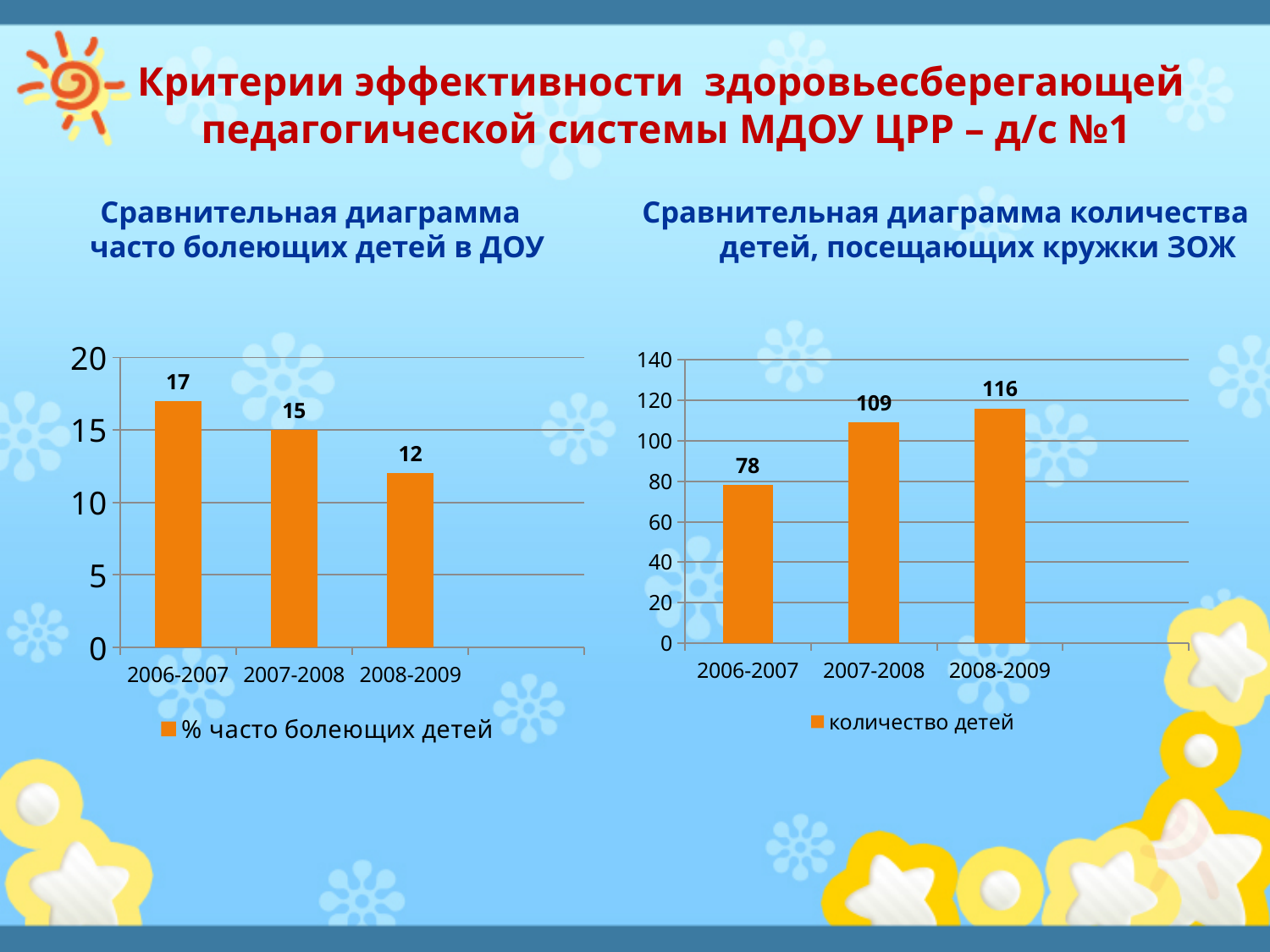
In the left chart (Сравнительная диаграмма часто болеющих детей в ДОУ), which year has the lowest value? 2008-2009 In the left chart (Сравнительная диаграмма часто болеющих детей в ДОУ), what is the value for 2006-2007? 17 In the right chart (Сравнительная диаграмма количества детей, посещающих кружки ЗОЖ), what is the value for 2007-2008? 109 In the left chart (Сравнительная диаграмма часто болеющих детей в ДОУ), do the values rise or fall from 2006-2007 to 2008-2009? fall In the right chart (Сравнительная диаграмма количества детей, посещающих кружки ЗОЖ), what is the difference between the values for 2008-2009 and 2006-2007? 38 What is the legend entry of the right chart (Сравнительная диаграмма количества детей, посещающих кружки ЗОЖ)? количество детей What kind of chart is the left chart (Сравнительная диаграмма часто болеющих детей в ДОУ)? bar chart In the right chart (Сравнительная диаграмма количества детей, посещающих кружки ЗОЖ), which year has the highest value? 2008-2009 In the left chart (Сравнительная диаграмма часто болеющих детей в ДОУ), what is the difference between the values for 2006-2007 and 2008-2009? 5 In the left chart (Сравнительная диаграмма часто болеющих детей в ДОУ), what is the value for 2008-2009? 12 In the right chart (Сравнительная диаграмма количества детей, посещающих кружки ЗОЖ), is the value for 2006-2007 greater or less than 100? less In the right chart (Сравнительная диаграмма количества детей, посещающих кружки ЗОЖ), how many categories are shown on the x axis? 3